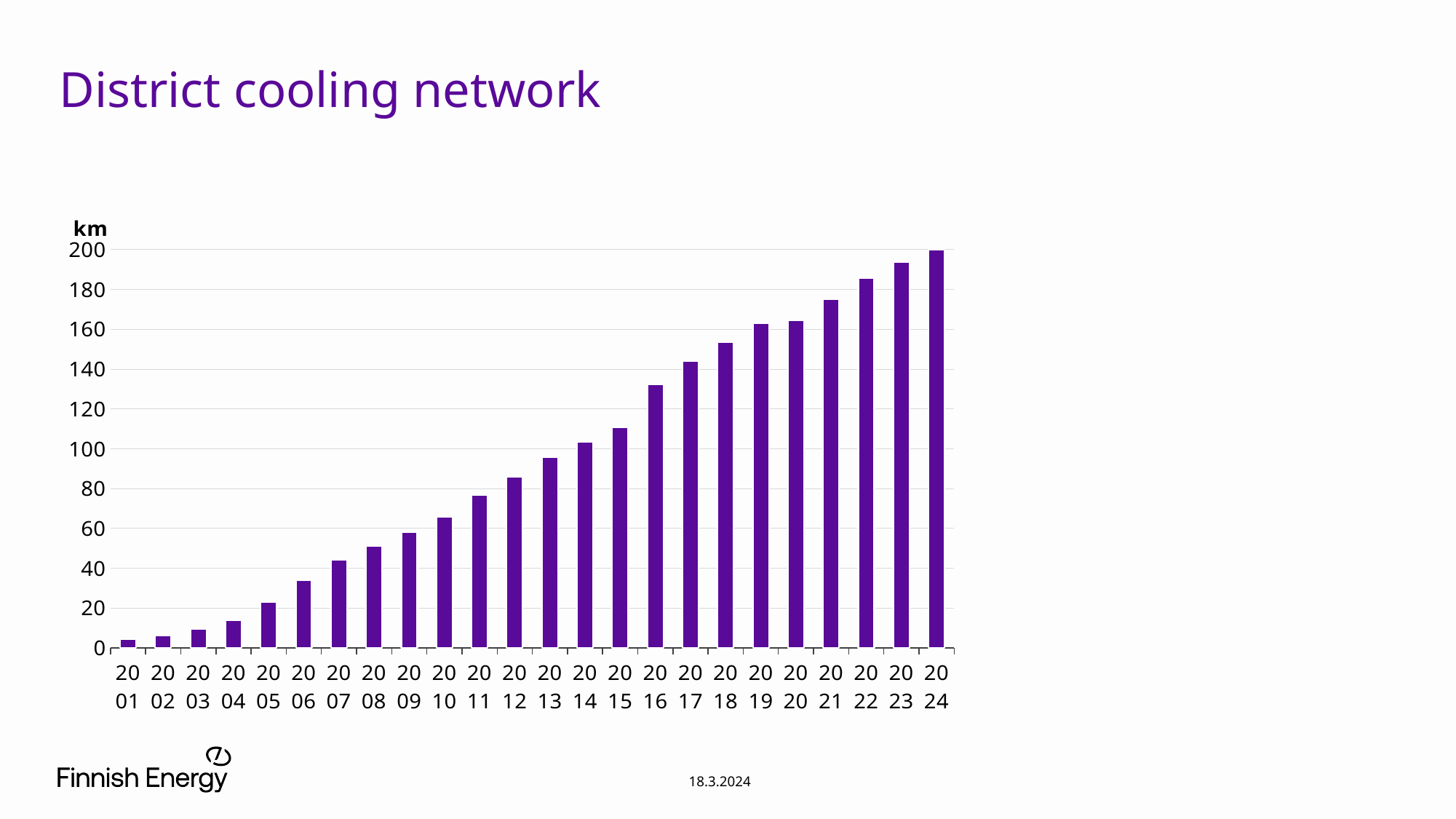
Which is larger, the value for 2010 or the value for 2016? 2016 What is the title of the chart on the slide? District cooling network Which year has the lowest value in the chart? 2001 How many years (bars) are plotted in the chart? 24 Is the value for 2021 greater or less than 180? less Which year has the highest value in the chart? 2024 What unit is shown on the vertical axis of the chart? km Is the value for 2013 greater or less than 100? less Do the values rise or fall from 2001 to 2024? rise Is the value for 2008 greater or less than 40? greater What kind of chart is shown on the slide? bar chart